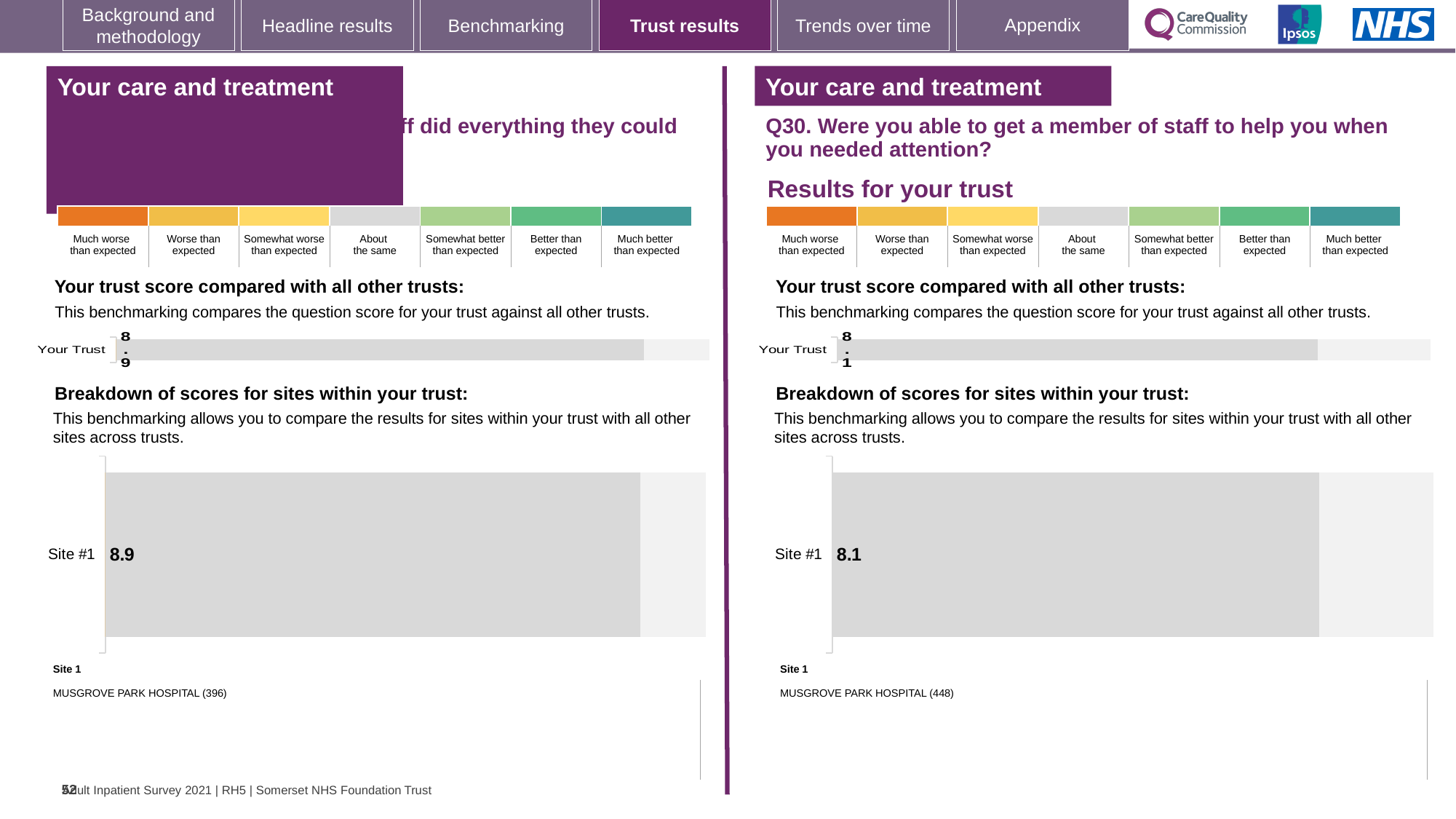
How many sites are shown in the breakdown of scores chart on the right side of the slide (Q30)? 1 On the right side of the slide (Q30), what is the score shown for Site #1 in the breakdown of scores for sites within your trust? 8.1 What is the question number shown above the charts on the right side of the slide? Q30 What is the difference between the Site #1 score on the left side of the slide and the Site #1 score on the right side (Q30)? 0.8 Which hospital is listed as Site 1 on the left side of the slide? MUSGROVE PARK HOSPITAL (396) Which Site #1 score is larger: the one on the left side of the slide or the one on the right side (Q30)? Left side (8.9) On the left side of the slide, what is the score shown for Your Trust in the trust score comparison chart? 8.9 What type of chart is used to show the Site #1 score on the right side of the slide (Q30)? Bar chart On the right side of the slide (Q30), what is the score shown for Your Trust in the trust score comparison chart? 8.1 How many sites are shown in the breakdown of scores chart on the left side of the slide? 1 Which hospital is listed as Site 1 on the right side of the slide (Q30)? MUSGROVE PARK HOSPITAL (448) On the left side of the slide, what is the score shown for Site #1 in the breakdown of scores for sites within your trust? 8.9